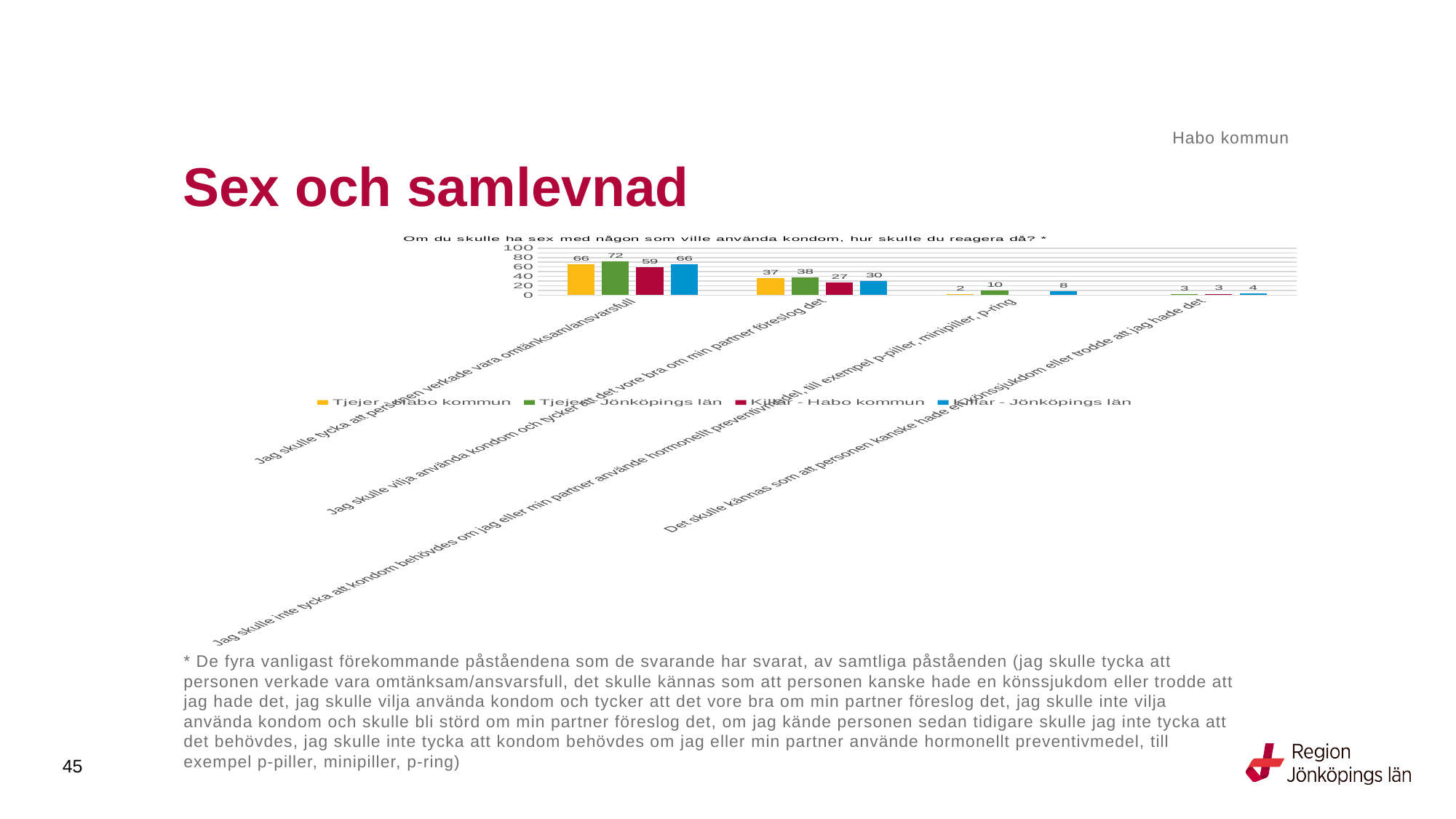
Which series has the lowest value for the statement 'Jag skulle vilja använda kondom och tycker att det vore bra om min partner föreslog det'? Killar - Habo kommun How many series does the legend list? 4 What is the value for Killar - Habo kommun for the statement 'Jag skulle tycka att personen verkade vara omtänksam/ansvarsfull'? 59 What is the value for Tjejer - Habo kommun for the statement 'Jag skulle vilja använda kondom och tycker att det vore bra om min partner föreslog det'? 37 What is the value for Killar - Jönköpings län for the statement 'Jag skulle vilja använda kondom och tycker att det vore bra om min partner föreslog det'? 30 What is the value for Tjejer - Jönköpings län for the statement 'Jag skulle tycka att personen verkade vara omtänksam/ansvarsfull'? 72 What colour represents Killar - Jönköpings län in the chart? blue What type of chart is shown on the slide? bar chart What is the difference between Tjejer - Jönköpings län and Killar - Habo kommun for the statement 'Jag skulle tycka att personen verkade vara omtänksam/ansvarsfull'? 13 What is the value for Tjejer - Jönköpings län for the statement 'Jag skulle inte tycka att kondom behövdes om jag eller min partner använde hormonellt preventivmedel, till exempel p-piller, minipiller, p-ring'? 10 Which is larger for the statement 'Jag skulle vilja använda kondom och tycker att det vore bra om min partner föreslog det': Tjejer - Habo kommun or Killar - Habo kommun? Tjejer - Habo kommun Which series has the highest value for the statement 'Jag skulle tycka att personen verkade vara omtänksam/ansvarsfull'? Tjejer - Jönköpings län